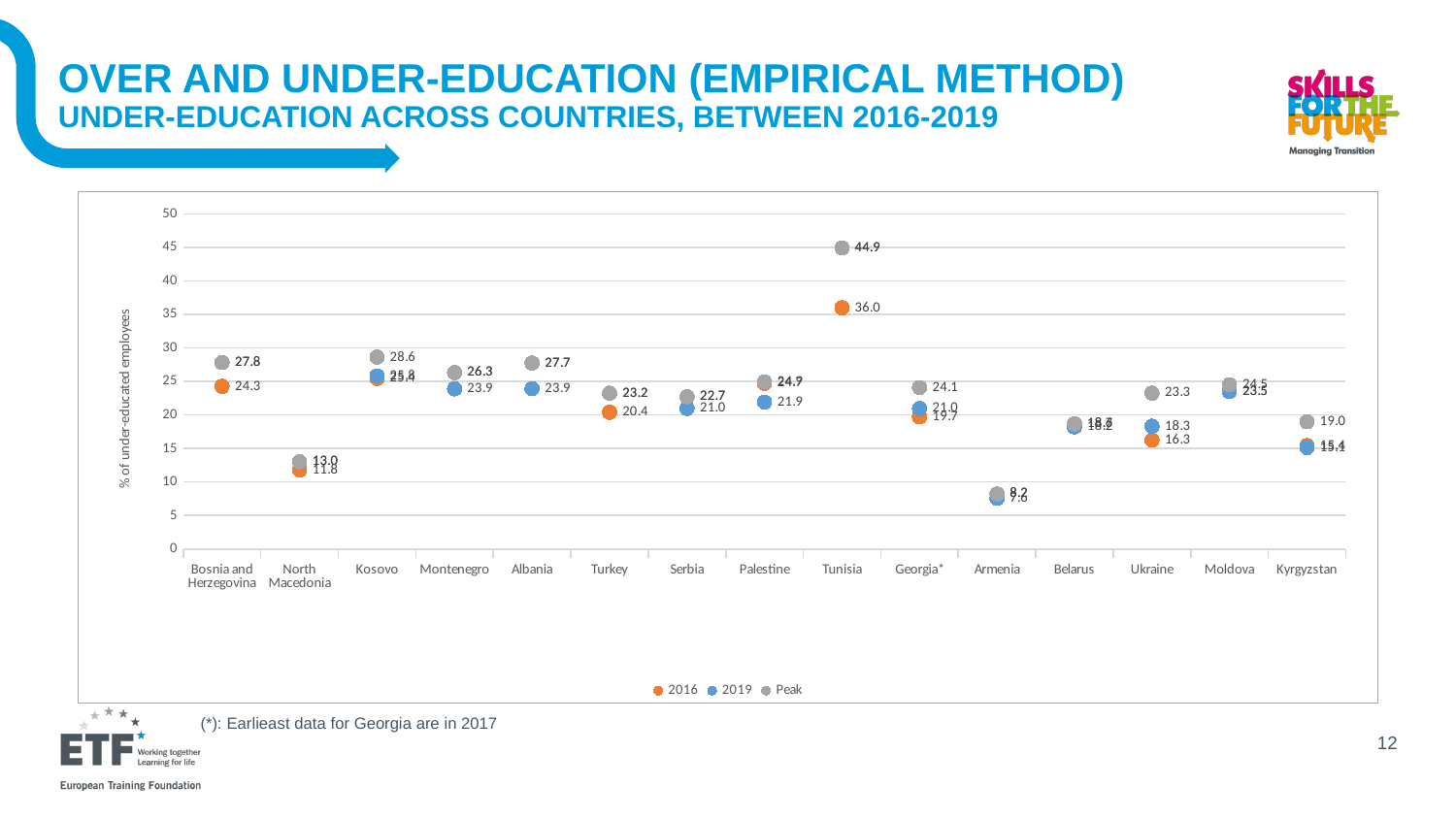
Which country has the lowest Peak value? Armenia What is the Peak value for Tunisia? 44.9 How many series does the legend list? 3 What is the difference between the Peak and 2016 values for Tunisia? 8.9 What is the 2016 value for Tunisia? 36.0 How many countries are shown on the x axis? 15 Which is larger, the Peak value for Kosovo or the Peak value for Albania? Kosovo What is the label of the y axis? % of under-educated employees What is the 2016 value for Georgia*? 19.7 Which country has the highest Peak value? Tunisia What is the 2016 value for Ukraine? 16.3 What is the 2019 value for Albania? 23.9